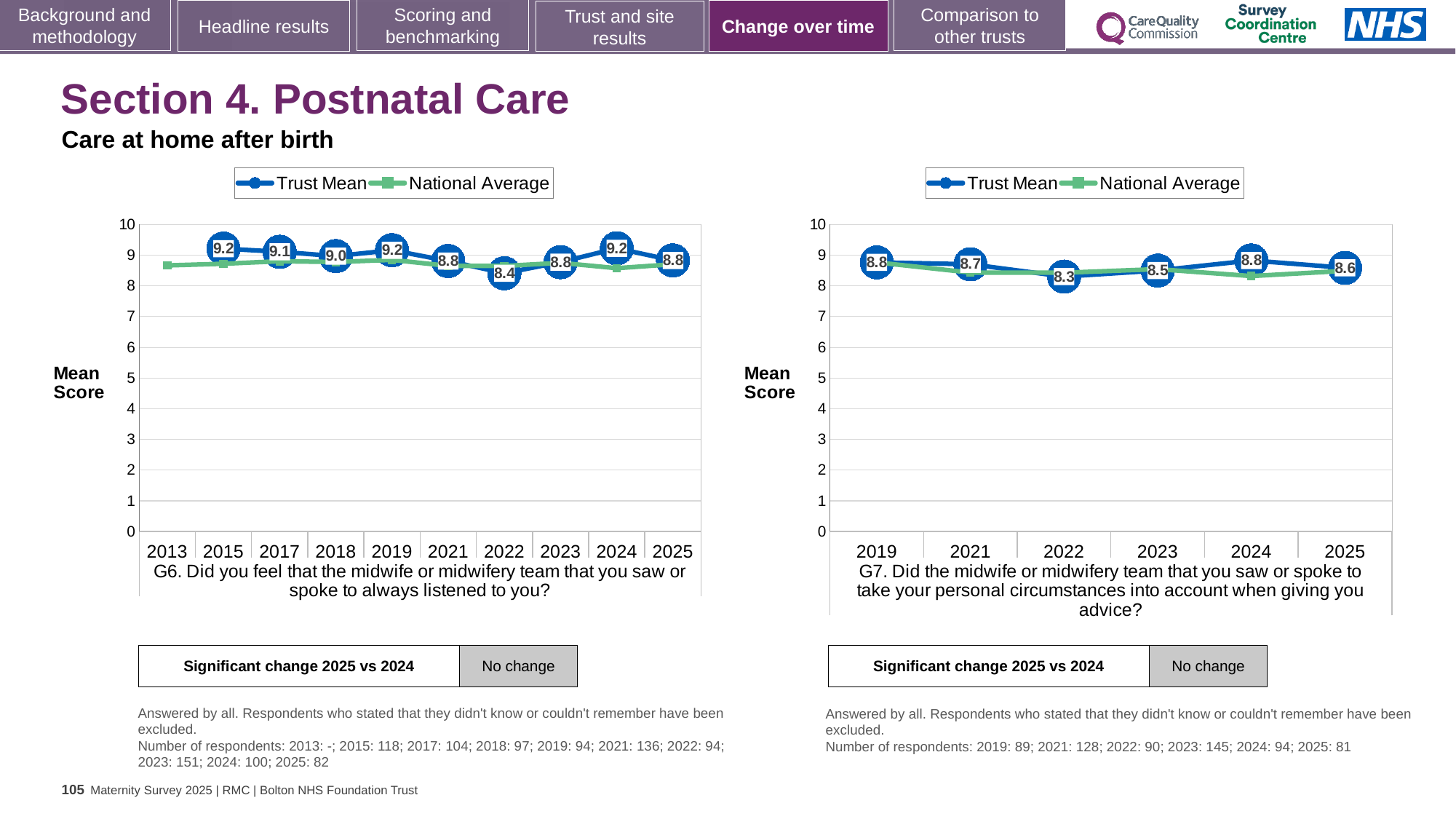
In the right chart (G7), what is the Trust Mean score for 2025? 8.6 How many years are shown on the x axis of the right chart (G7)? 6 How many series does the legend of the left chart (G6) list? 2 In the right chart (G7), what is the difference between the Trust Mean scores for 2024 and 2022? 0.5 In the right chart (G7), which year has the lowest Trust Mean score? 2022 In the right chart (G7), what is the Trust Mean score for 2019? 8.8 In the left chart (G6), what is the Trust Mean score for 2025? 8.8 In the left chart (G6), what is the Trust Mean score for 2022? 8.4 In the left chart (G6), what is the difference between the Trust Mean scores for 2024 and 2025? 0.4 In the right chart (G7), is the Trust Mean score higher in 2021 or in 2023? 2021 In the left chart (G6), which year has the lowest Trust Mean score? 2022 In the left chart (G6), is the National Average value for 2013 greater or less than 8? greater